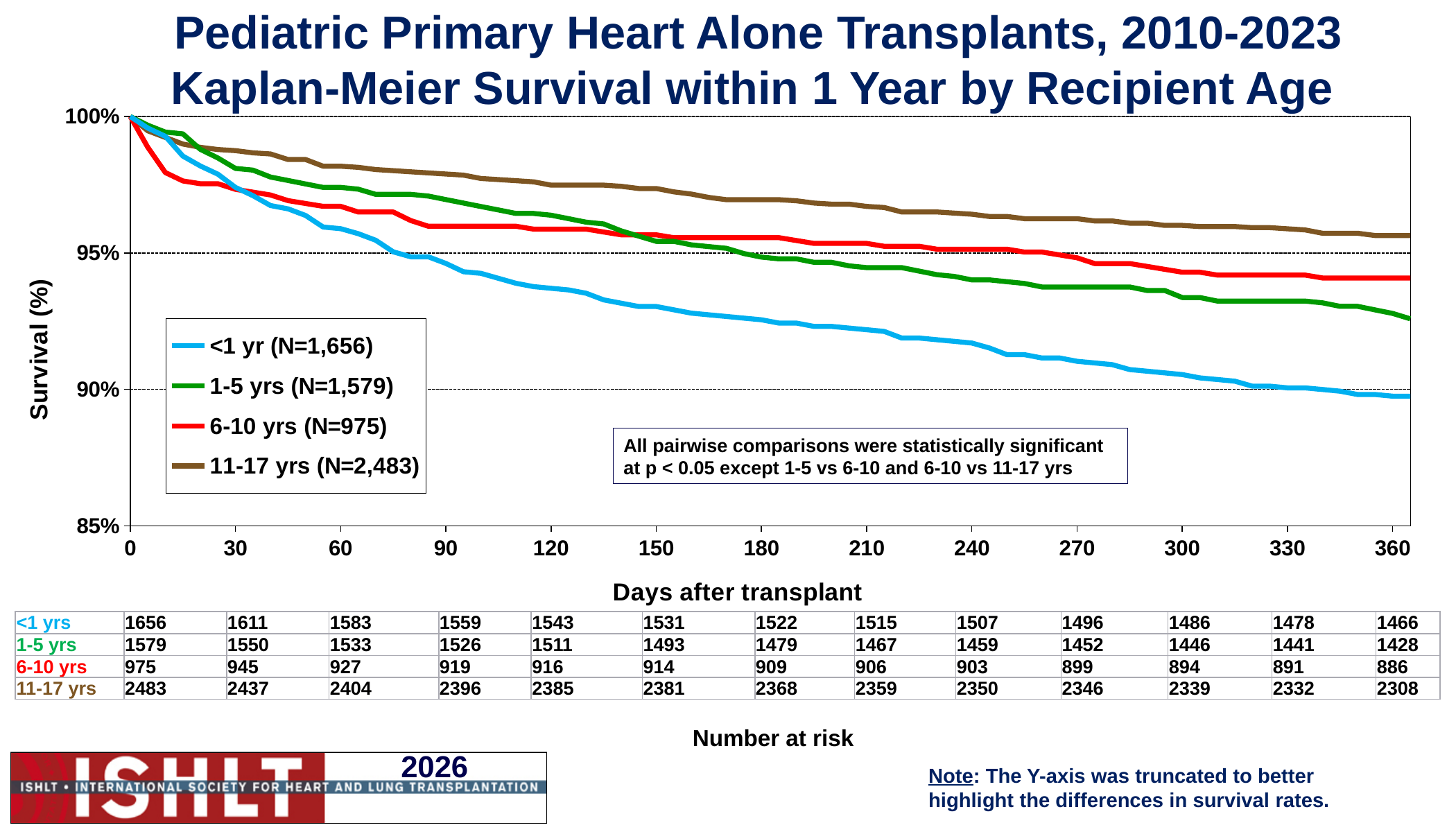
Is the survival for the <1 yr group at 360 days greater or less than 90%? less Which recipient age group has the highest survival at 360 days after transplant? 11-17 yrs Is the survival for the 1-5 yrs group at 360 days greater or less than 95%? less How many series does the legend list? 4 Is the survival for the 11-17 yrs group at 360 days greater or less than 95%? greater In the number at risk table, how many 11-17 yrs recipients are at risk at the last time point (360 days)? 2308 Do the survival curves rise or fall as days after transplant increase? fall What kind of chart is shown on the slide? line chart At 360 days, which group has higher survival: 1-5 yrs or 6-10 yrs? 6-10 yrs Which recipient age group has the lowest survival at 360 days after transplant? <1 yr What is the label of the x axis? Days after transplant According to the legend, what is the N for the 6-10 yrs group? 975